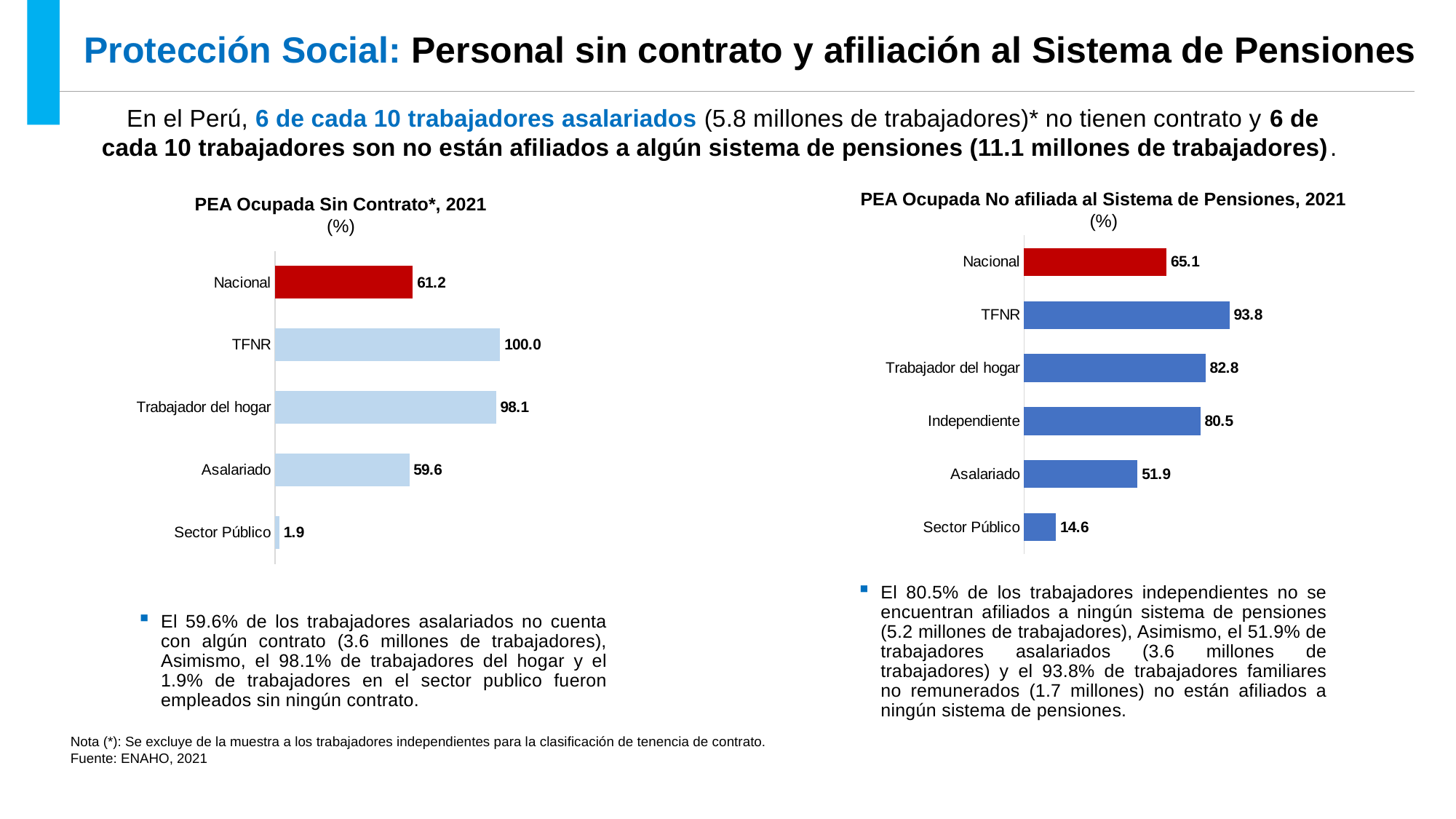
In the chart 'PEA Ocupada No afiliada al Sistema de Pensiones, 2021', what is the value for Independiente? 80.5 In the chart 'PEA Ocupada No afiliada al Sistema de Pensiones, 2021', what is the difference between Nacional and Sector Público? 50.5 In the chart 'PEA Ocupada Sin Contrato*, 2021', which category has the highest value? TFNR In the chart 'PEA Ocupada No afiliada al Sistema de Pensiones, 2021', how many categories are shown? 6 In the chart 'PEA Ocupada No afiliada al Sistema de Pensiones, 2021', which category has the highest value? TFNR In the chart 'PEA Ocupada No afiliada al Sistema de Pensiones, 2021', which is larger, Trabajador del hogar or Asalariado? Trabajador del hogar In the chart 'PEA Ocupada Sin Contrato*, 2021', what is the difference between Trabajador del hogar and Asalariado? 38.5 In the chart 'PEA Ocupada Sin Contrato*, 2021', how many categories are shown? 5 What type of chart is 'PEA Ocupada Sin Contrato*, 2021'? Bar chart In the chart 'PEA Ocupada No afiliada al Sistema de Pensiones, 2021', which category has the lowest value? Sector Público In the chart 'PEA Ocupada Sin Contrato*, 2021', what is the value for Nacional? 61.2 In the chart 'PEA Ocupada Sin Contrato*, 2021', which category has the lowest value? Sector Público